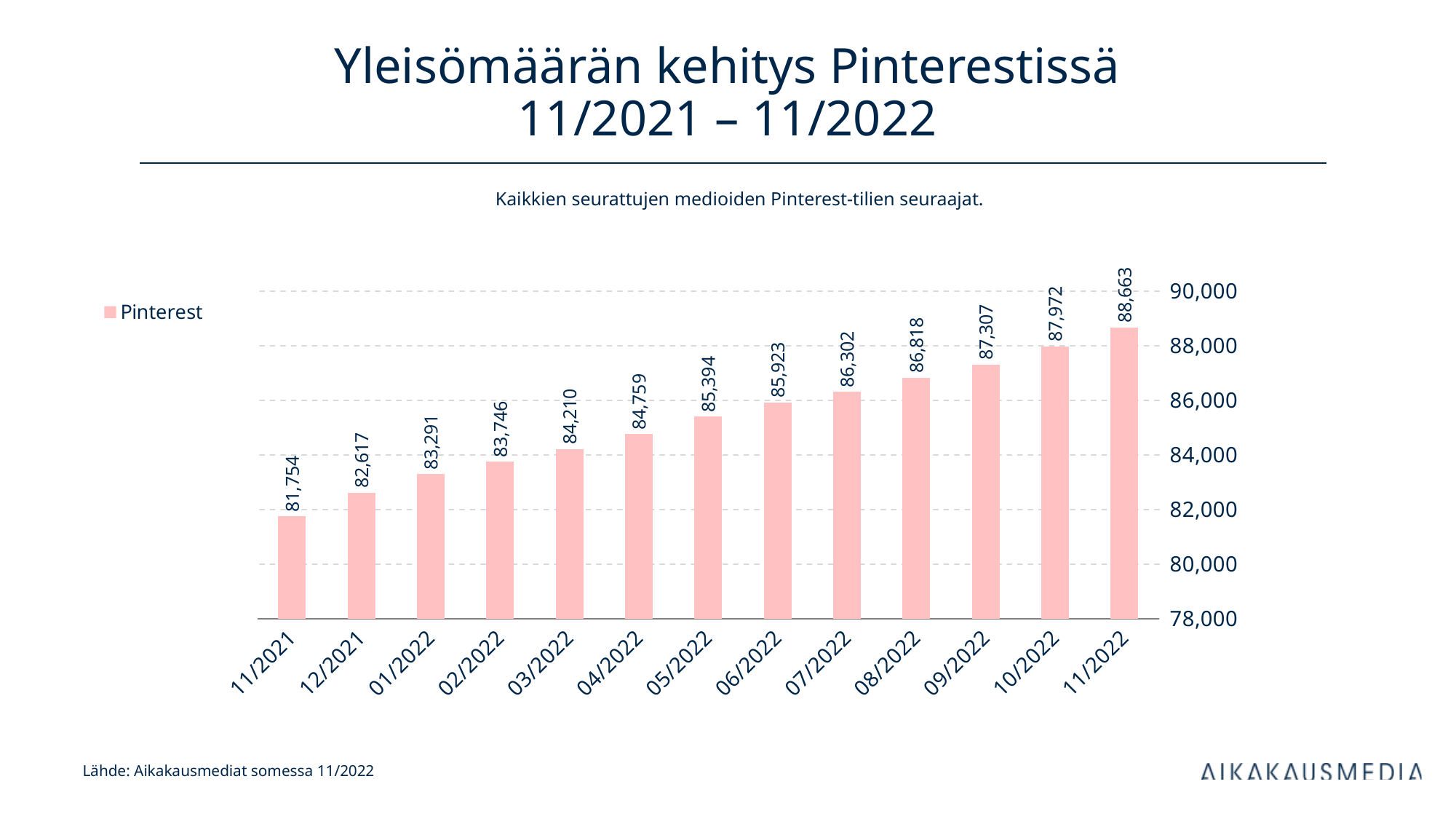
What kind of chart is shown on the slide? Bar chart What is the value for 05/2022? 85,394 Which month has the lowest value? 11/2021 Which month has the highest value? 11/2022 Which is larger, the value for 03/2022 or the value for 07/2022? 07/2022 How many months are shown on the x axis? 13 What is the value for 11/2022? 88,663 Is the value for 08/2022 greater or less than 86,000? greater What is the value for 11/2021? 81,754 Do the values rise or fall from 11/2021 to 11/2022? Rise What is the difference between the values for 11/2022 and 11/2021? 6,909 What is the difference between the values for 10/2022 and 09/2022? 665